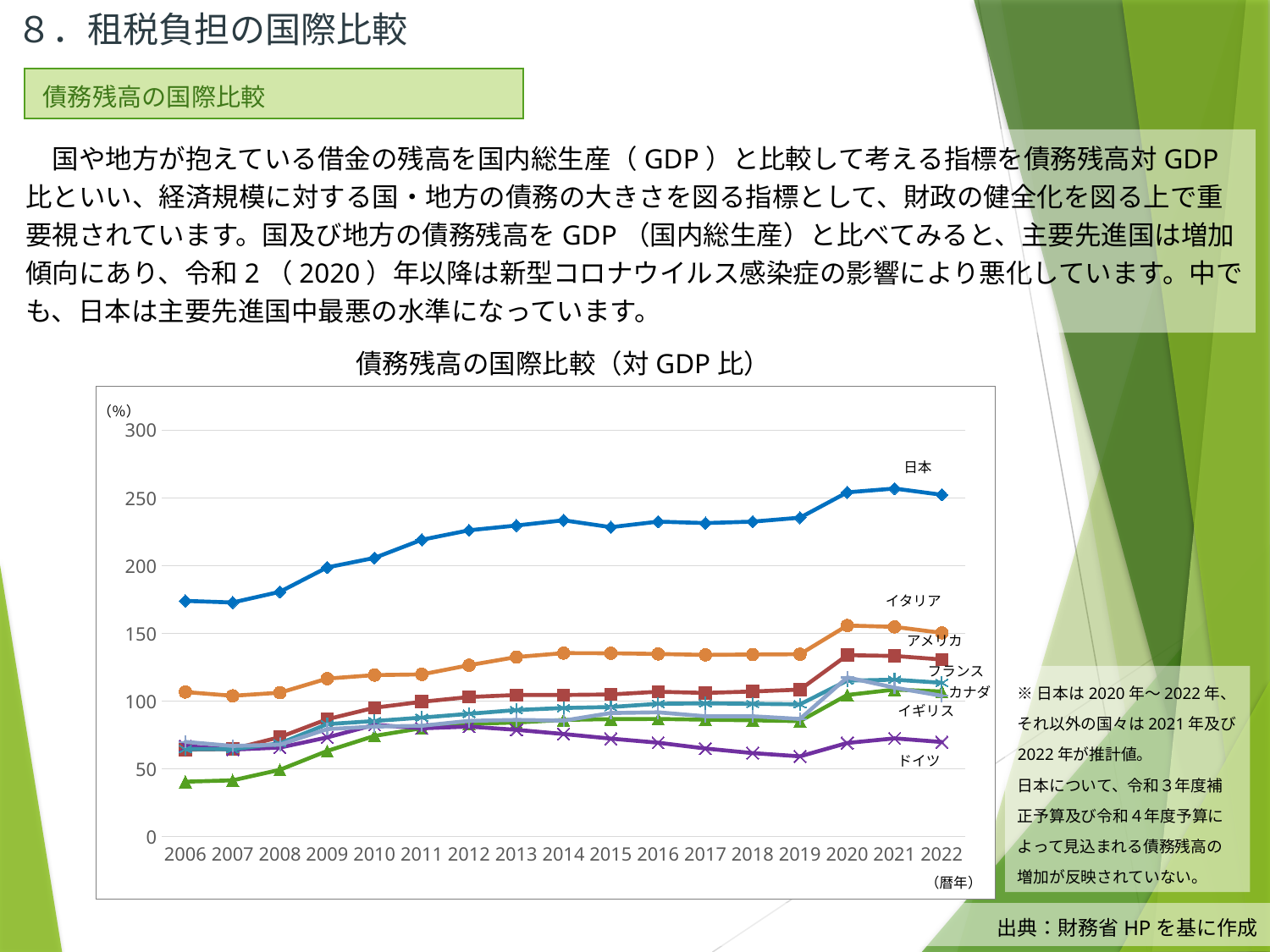
Is the value for 日本 in 2014 greater or less than 200? greater Which country has the lowest debt-to-GDP ratio in 2022? ドイツ Which country has the lowest value in 2006? イギリス Is the value for イギリス in 2006 greater or less than 50? less Is the value for アメリカ in 2020 greater or less than 100? greater Which country has the highest debt-to-GDP ratio in 2022? 日本 How many years are shown along the x axis of the chart? 17 What kind of chart is shown on the slide? line chart Which is larger in 2006, the value for ドイツ or the value for イギリス? ドイツ How many countries are plotted as lines in the chart 債務残高の国際比較（対GDP比）? 7 Does the line for 日本 generally rise or fall from 2006 to 2022? rise